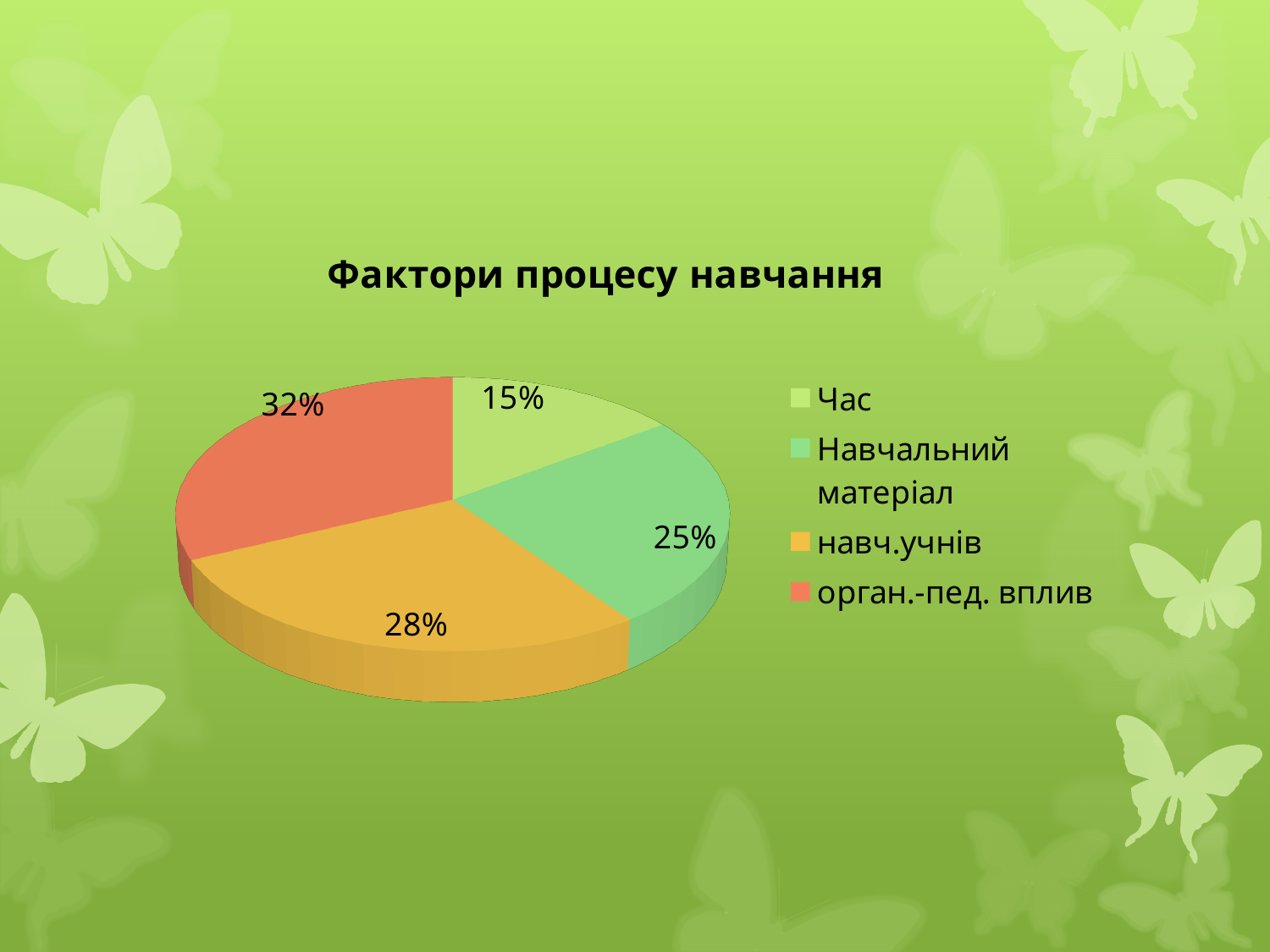
What share of the pie does "Навчальний матеріал" take? 25% Which category has the largest slice of the pie? орган.-пед. вплив How many categories does the pie chart have? 4 What colour is the slice for "навч.учнів"? orange/yellow What is the difference between the shares of "орган.-пед. вплив" and "Час"? 17% What kind of chart is shown on the slide? pie chart What share of the pie does "Час" take? 15% Which category has the smallest slice of the pie? Час What share of the pie does "навч.учнів" take? 28% Which is larger, the share for "навч.учнів" or the share for "Навчальний матеріал"? навч.учнів What is the title of the chart? Фактори процесу навчання